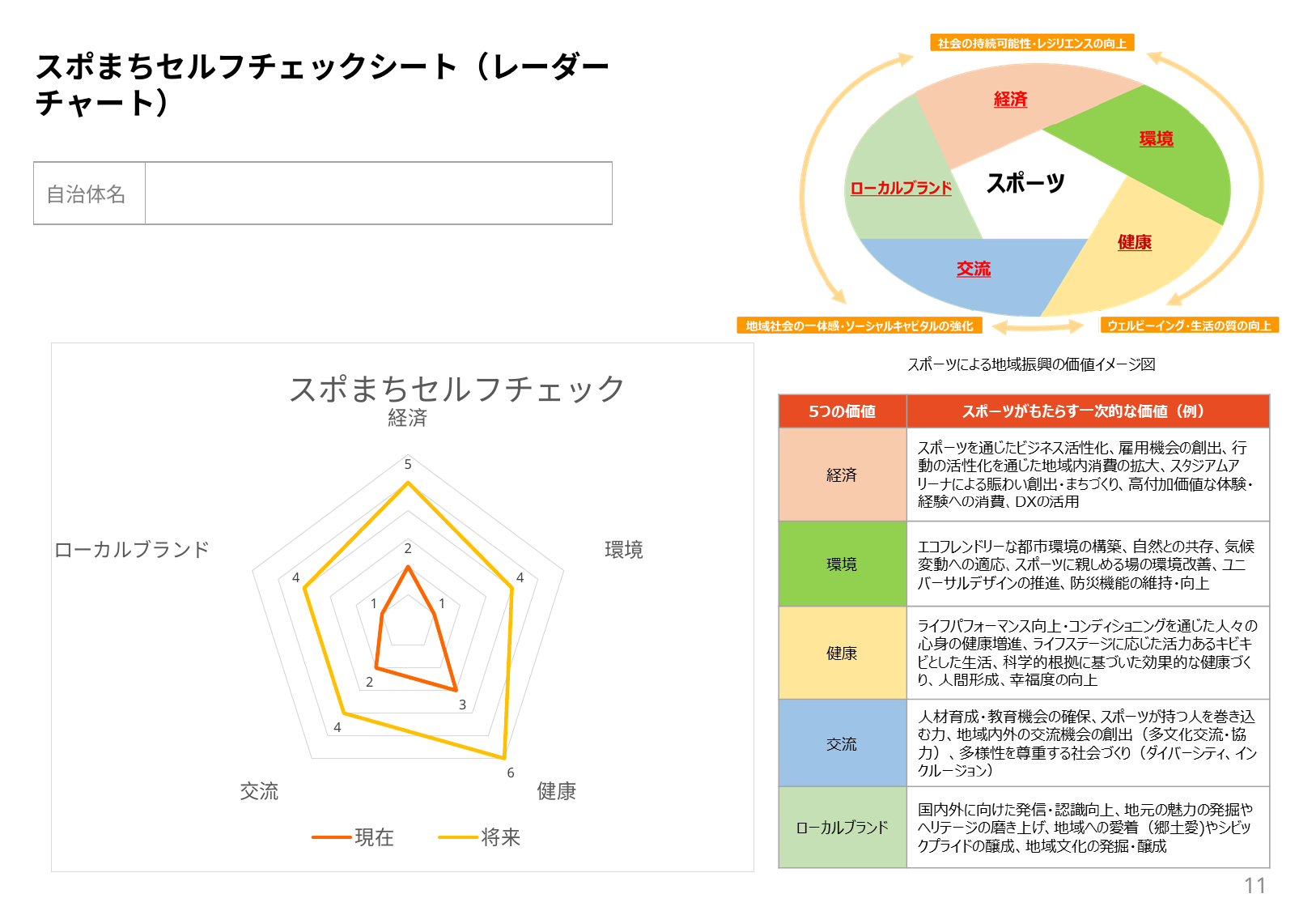
In the 'スポまちセルフチェック' chart, what is the 現在 value for 環境? 1 In the 'スポまちセルフチェック' chart, what is the 現在 value for 経済? 2 In the 'スポまちセルフチェック' chart, what is the 将来 value for 健康? 6 In the 'スポまちセルフチェック' chart, which category has the highest 現在 value? 健康 In the 'スポまちセルフチェック' chart, which is larger: the 現在 value for 交流 or the 現在 value for 健康? 健康 In the 'スポまちセルフチェック' chart, what is the 将来 value for ローカルブランド? 4 In the 'スポまちセルフチェック' chart, what is the difference between the 将来 and 現在 values for 健康? 3 What kind of chart is the 'スポまちセルフチェック' chart? radar chart How many series does the legend of the 'スポまちセルフチェック' chart list? 2 How many categories (axes) does the 'スポまちセルフチェック' radar chart have? 5 In the 'スポまちセルフチェック' chart, what is the difference between the 将来 and 現在 values for 経済? 3 In the 'スポまちセルフチェック' chart, which category has the highest 将来 value? 健康